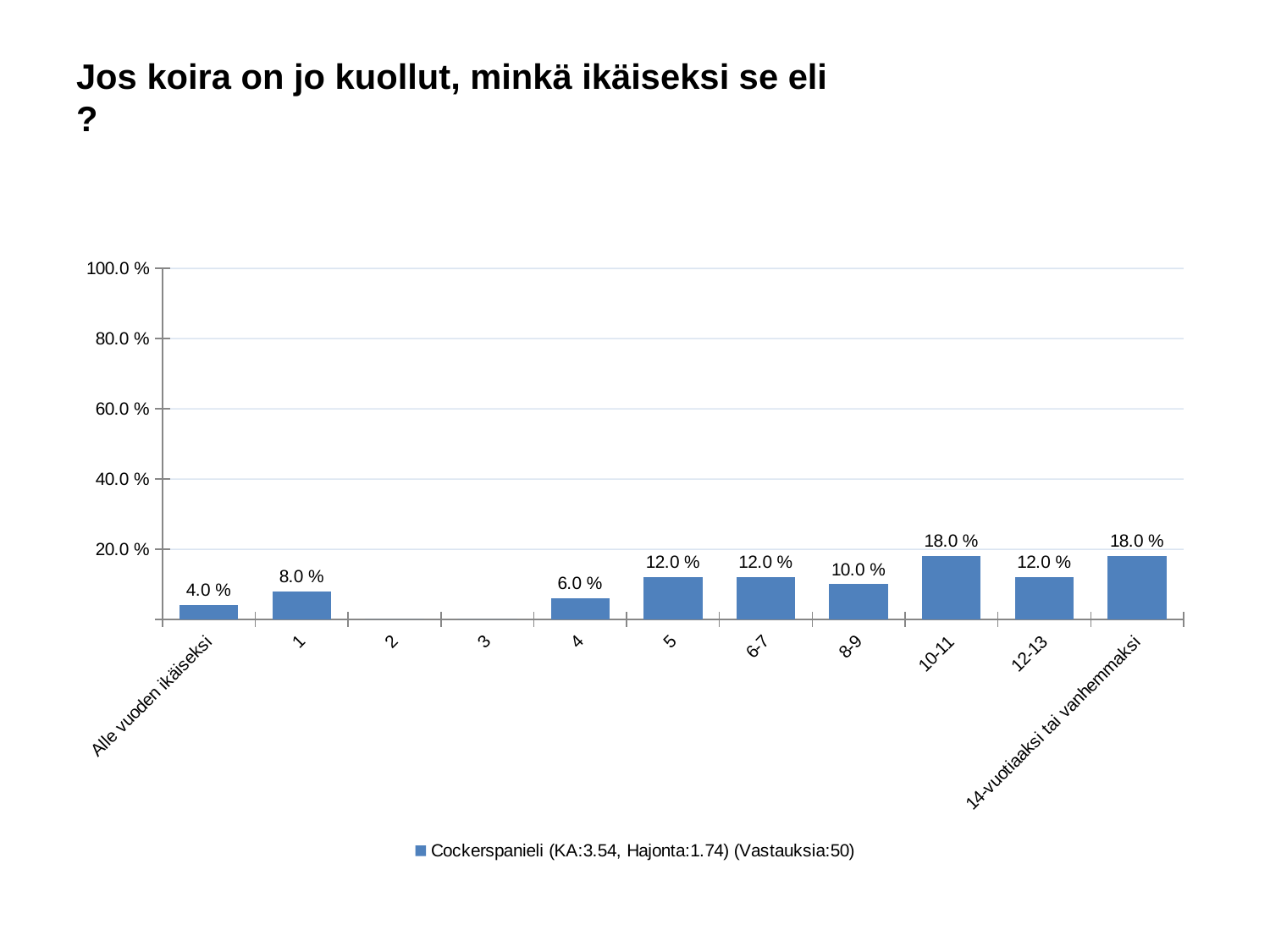
How many categories are shown on the x axis? 11 What is the value for the category "4"? 6.0 % What kind of chart is shown on the slide? bar chart What is the value for the category "14-vuotiaaksi tai vanhemmaksi"? 18.0 % Is the value for "10-11" greater or less than 20.0 %? less What is the value for the category "1"? 8.0 % How many series does the legend list? 1 What is the value for the category "8-9"? 10.0 % What is the difference between the values for "5" and "Alle vuoden ikäiseksi"? 8.0 % Which is larger, the value for "12-13" or the value for "1"? 12-13 What is the difference between the values for "10-11" and "8-9"? 8.0 % What is the value for the category "Alle vuoden ikäiseksi"? 4.0 %